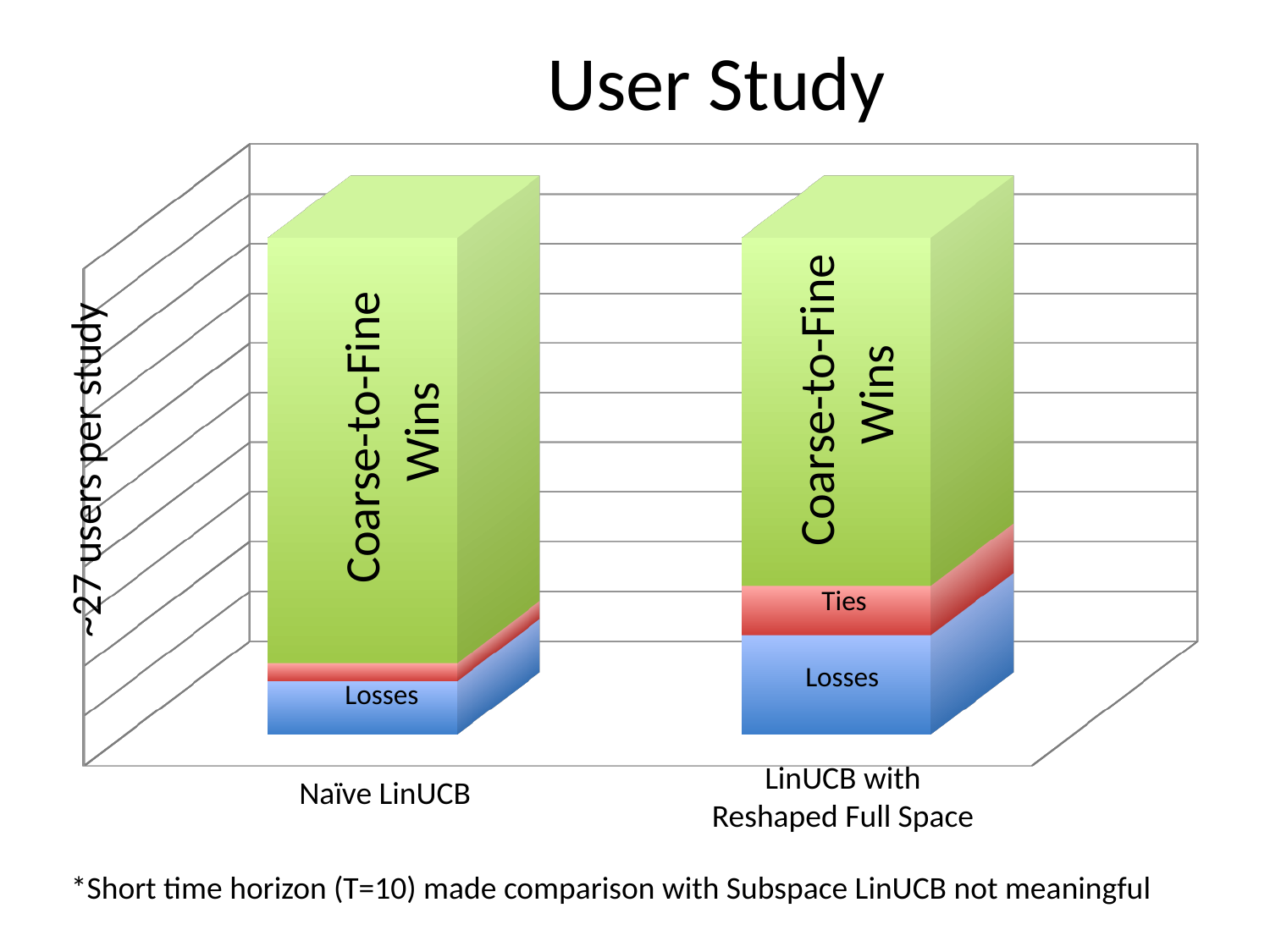
Which bar has the larger Losses segment, Naïve LinUCB or LinUCB with Reshaped Full Space? LinUCB with Reshaped Full Space Which segment is the smallest in the LinUCB with Reshaped Full Space bar? Ties Which segment is the smallest in the Naïve LinUCB bar? Ties What kind of chart is shown on the slide? Stacked bar chart Which segment is the largest in the LinUCB with Reshaped Full Space bar? Coarse-to-Fine Wins Which segment is the largest in the Naïve LinUCB bar? Coarse-to-Fine Wins Which bar has the larger Ties segment, Naïve LinUCB or LinUCB with Reshaped Full Space? LinUCB with Reshaped Full Space What is the label on the vertical axis? ~27 users per study Which bar has the larger Coarse-to-Fine Wins segment, Naïve LinUCB or LinUCB with Reshaped Full Space? Naïve LinUCB How many segments are stacked in each bar? 3 How many categories (bars) are shown on the x axis? 2 What is the title of the chart? User Study